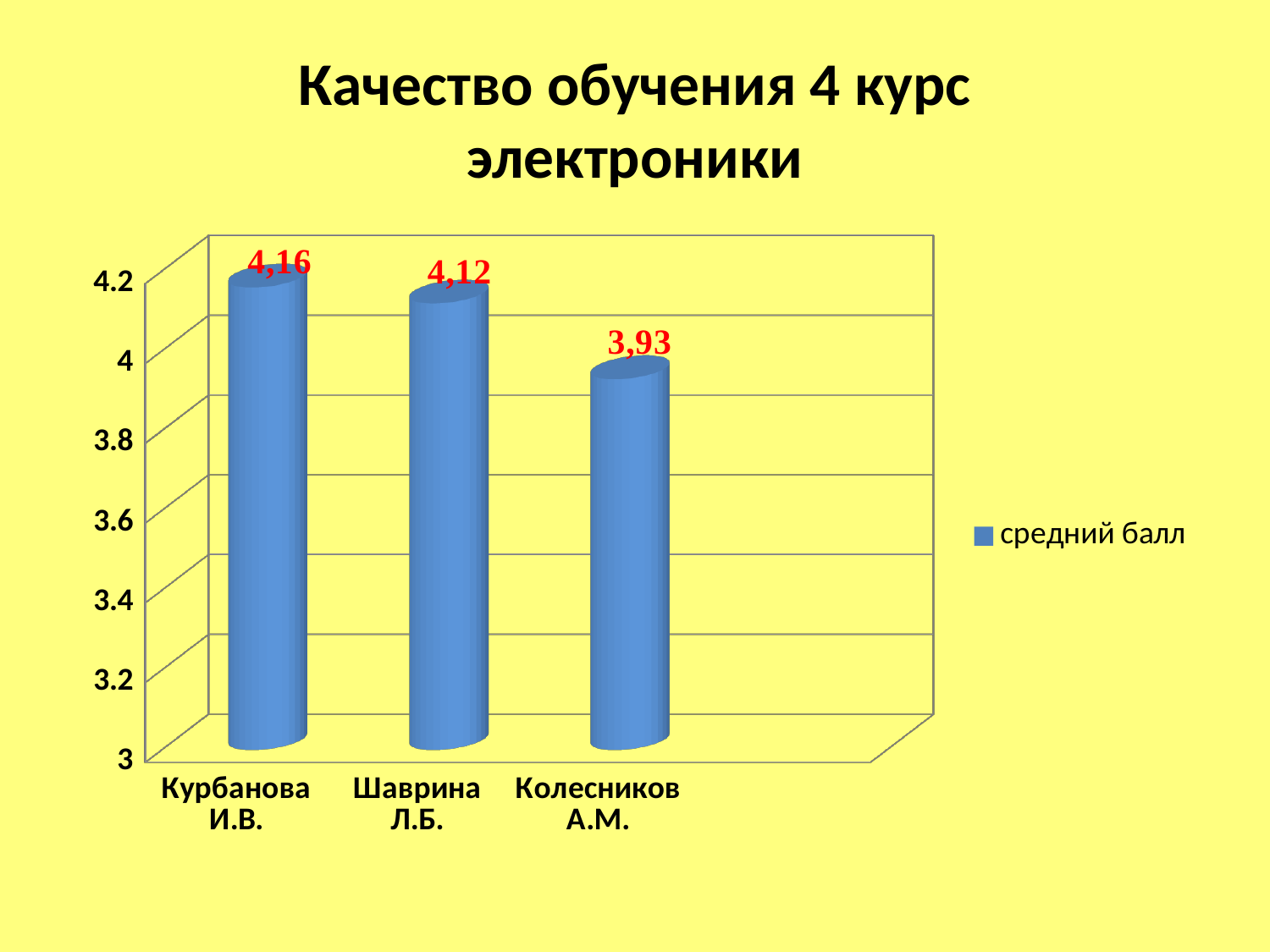
What is the average score for Колесников А.М.? 3,93 What is the average score (средний балл) for Курбанова И.В.? 4,16 Is the value for Колесников А.М. greater or less than 4? less What kind of chart is shown on the slide? bar chart What is the difference between the average scores of Шаврина Л.Б. and Колесников А.М.? 0,19 What is the average score for Шаврина Л.Б.? 4,12 How many series does the legend list? 1 How many teachers are shown on the chart? 3 What is the difference between the average scores of Курбанова И.В. and Колесников А.М.? 0,23 Who has a higher average score, Шаврина Л.Б. or Колесников А.М.? Шаврина Л.Б. Which teacher has the lowest average score? Колесников А.М. Which teacher has the highest average score? Курбанова И.В.